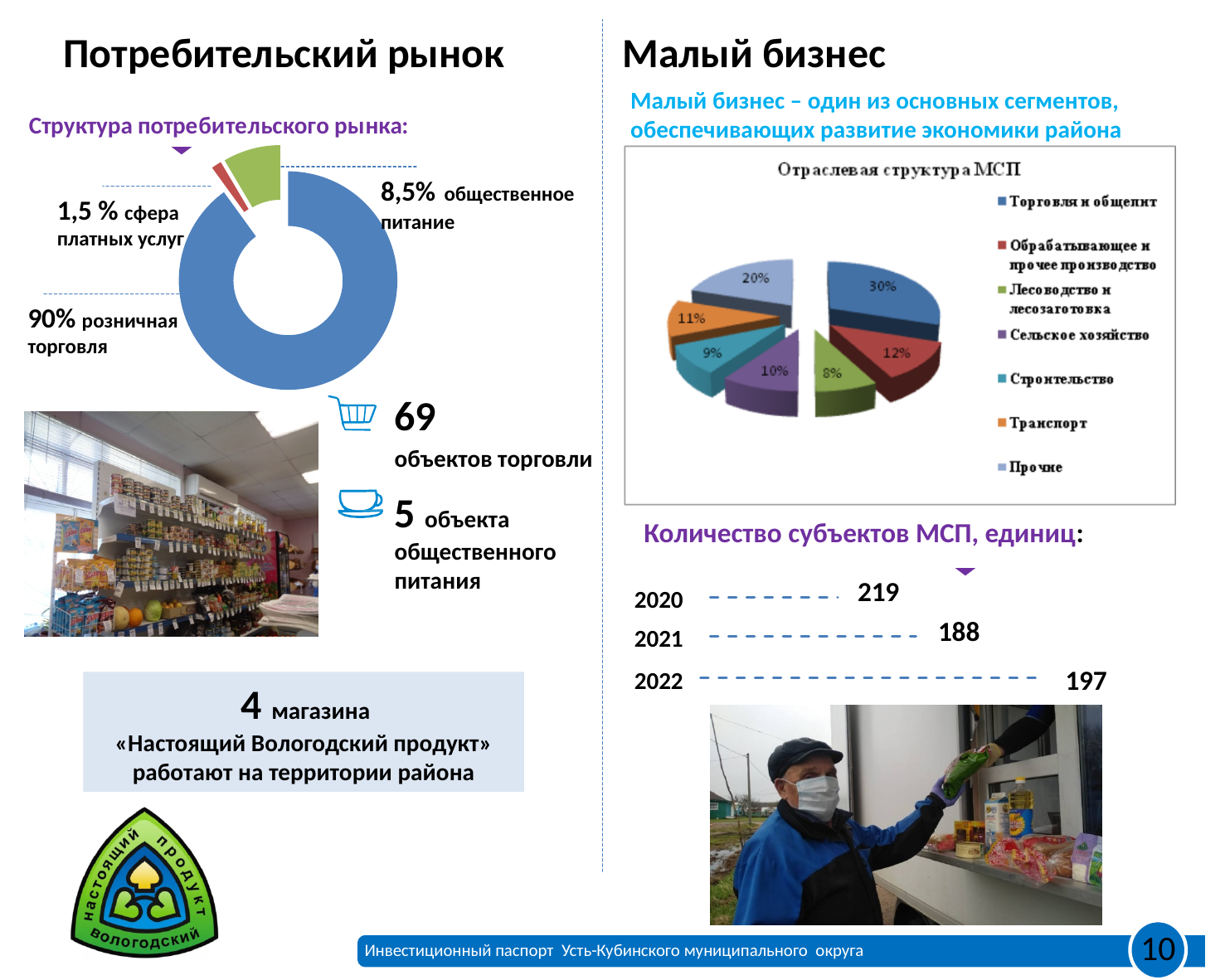
On the chart 'Структура потребительского рынка', which segment is the smallest? сфера платных услуг On the chart 'Отраслевая структура МСП', how many sectors does the legend list? 7 On the chart 'Отраслевая структура МСП', what share does Транспорт have? 11% On the chart 'Отраслевая структура МСП', which is larger: Сельское хозяйство or Строительство? Сельское хозяйство On the chart 'Отраслевая структура МСП', what share does Торговля и общепит have? 30% On the chart 'Отраслевая структура МСП', which sector has the smallest share? Лесоводство и лесозаготовка On the chart 'Структура потребительского рынка', how many segments are shown? 3 On the chart 'Структура потребительского рынка', what is the difference between the shares of общественное питание and сфера платных услуг? 7% On the chart 'Структура потребительского рынка', what share does общественное питание have? 8,5% What kind of chart is 'Отраслевая структура МСП'? pie chart On the chart 'Отраслевая структура МСП', which sector has the largest share? Торговля и общепит On the chart 'Структура потребительского рынка', what share does розничная торговля have? 90%